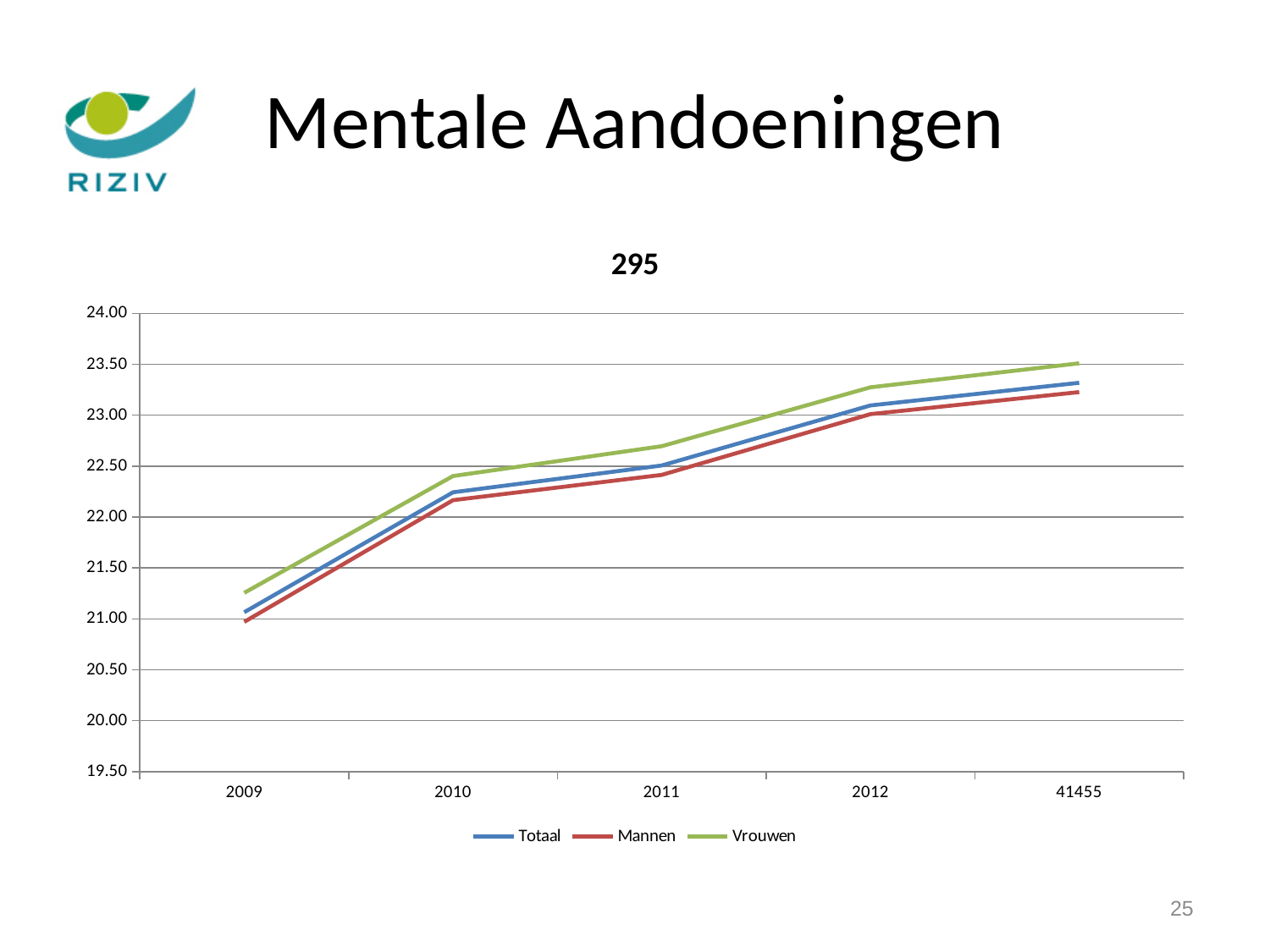
Is the value for Mannen in 2010 greater or less than 22.00? greater Which is larger in 2009, the value for Vrouwen or the value for Mannen? Vrouwen Is the value for Vrouwen in 2009 greater or less than 21.50? less Is the value for Vrouwen in 2012 greater or less than 23.00? greater How many series does the legend list? 3 Which series is shown in green in the legend? Vrouwen At which x-axis category is the value for Vrouwen lowest? 2009 Do the values for Totaal rise or fall from 2009 to 41455? rise How many points are plotted along the x axis for each series? 5 What is the title of the chart? 295 What kind of chart is shown on the slide? line chart